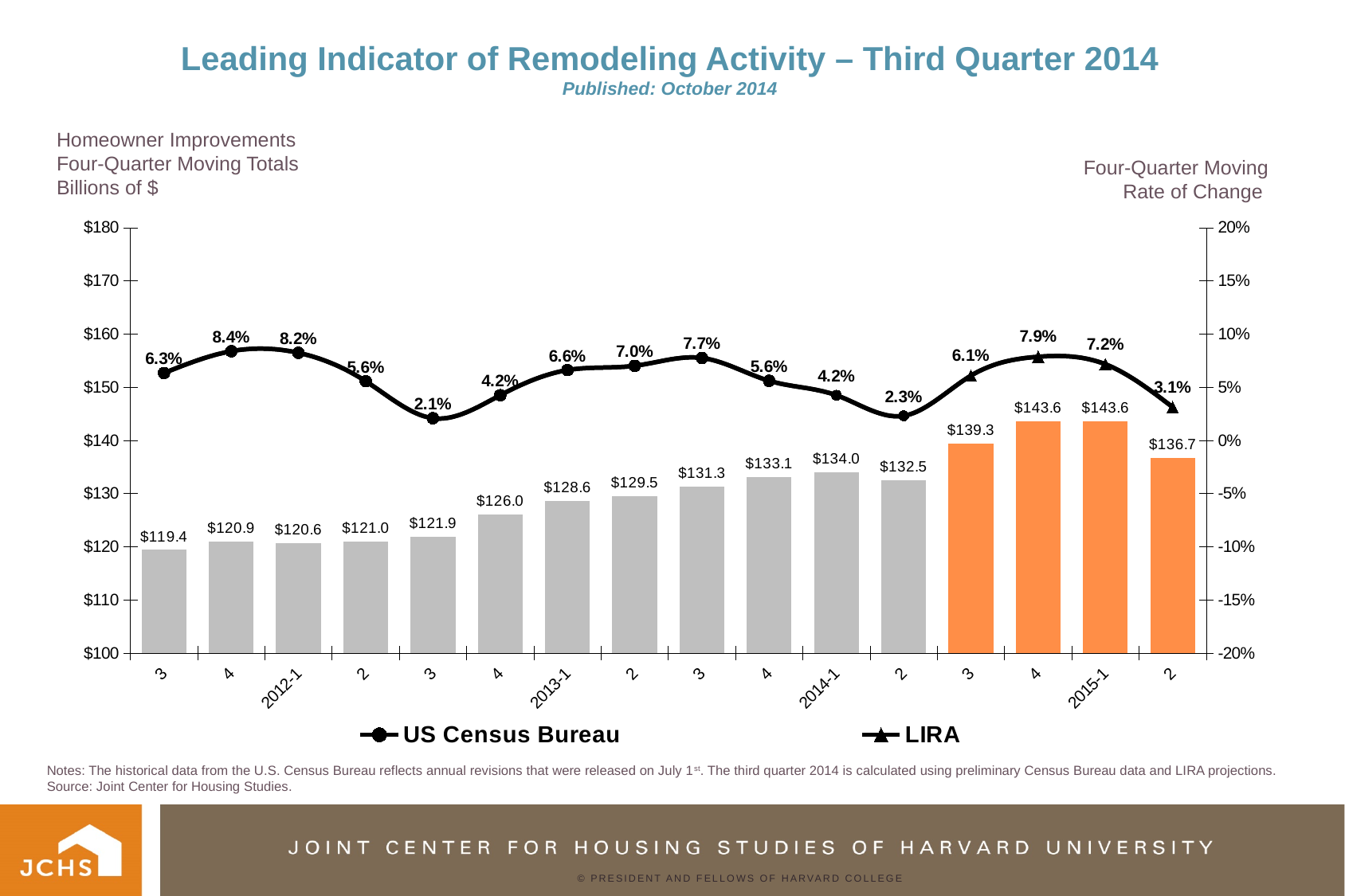
Do the four-quarter moving totals rise or fall from 2012-1 to 2014-1? Rise What is the lowest four-quarter moving total shown by the bars? $119.4 What is the four-quarter moving total for 2014-1? $134.0 What is the highest four-quarter moving total shown by the bars? $143.6 What is the four-quarter moving rate of change shown for 2013-1? 6.6% What is the difference between the four-quarter moving totals for 2014-1 and 2013-1? $5.4 What is the highest four-quarter moving rate of change shown on the line? 8.4% How many bars are plotted on the chart? 16 What is the lowest four-quarter moving rate of change shown on the line? 2.1% Which has the higher rate of change, 2012-1 or 2013-1? 2012-1 What kind of chart is shown on the slide? Bar chart with a line How many series does the legend list? 2